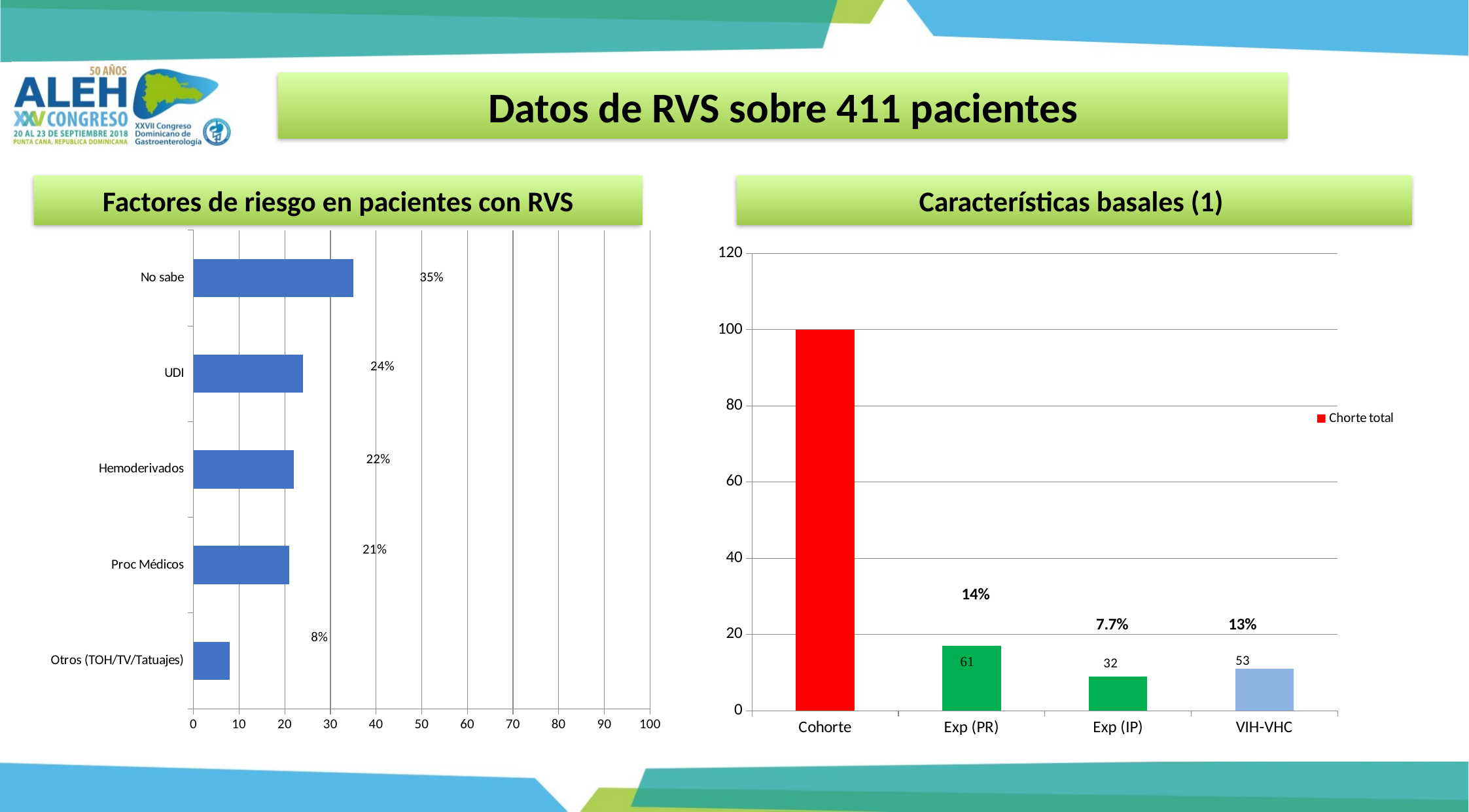
In the chart 'Factores de riesgo en pacientes con RVS', what percentage is shown for Otros (TOH/TV/Tatuajes)? 8% In the chart 'Factores de riesgo en pacientes con RVS', how many risk factor categories are shown? 5 In the chart 'Factores de riesgo en pacientes con RVS', what percentage is shown for UDI? 24% In the chart 'Características basales (1)', what is the legend entry? Chorte total In the chart 'Características basales (1)', is the value for Cohorte greater or less than 80? greater In the chart 'Factores de riesgo en pacientes con RVS', what is the difference in percentage points between No sabe and UDI? 11 What kind of chart is 'Factores de riesgo en pacientes con RVS'? Bar chart In the chart 'Características basales (1)', what percentage is shown for VIH-VHC? 13% In the chart 'Factores de riesgo en pacientes con RVS', what percentage is shown for No sabe? 35% In the chart 'Factores de riesgo en pacientes con RVS', which risk factor has the lowest percentage? Otros (TOH/TV/Tatuajes) In the chart 'Características basales (1)', what number is shown above the Exp (IP) bar? 32 In the chart 'Factores de riesgo en pacientes con RVS', which risk factor has the highest percentage? No sabe